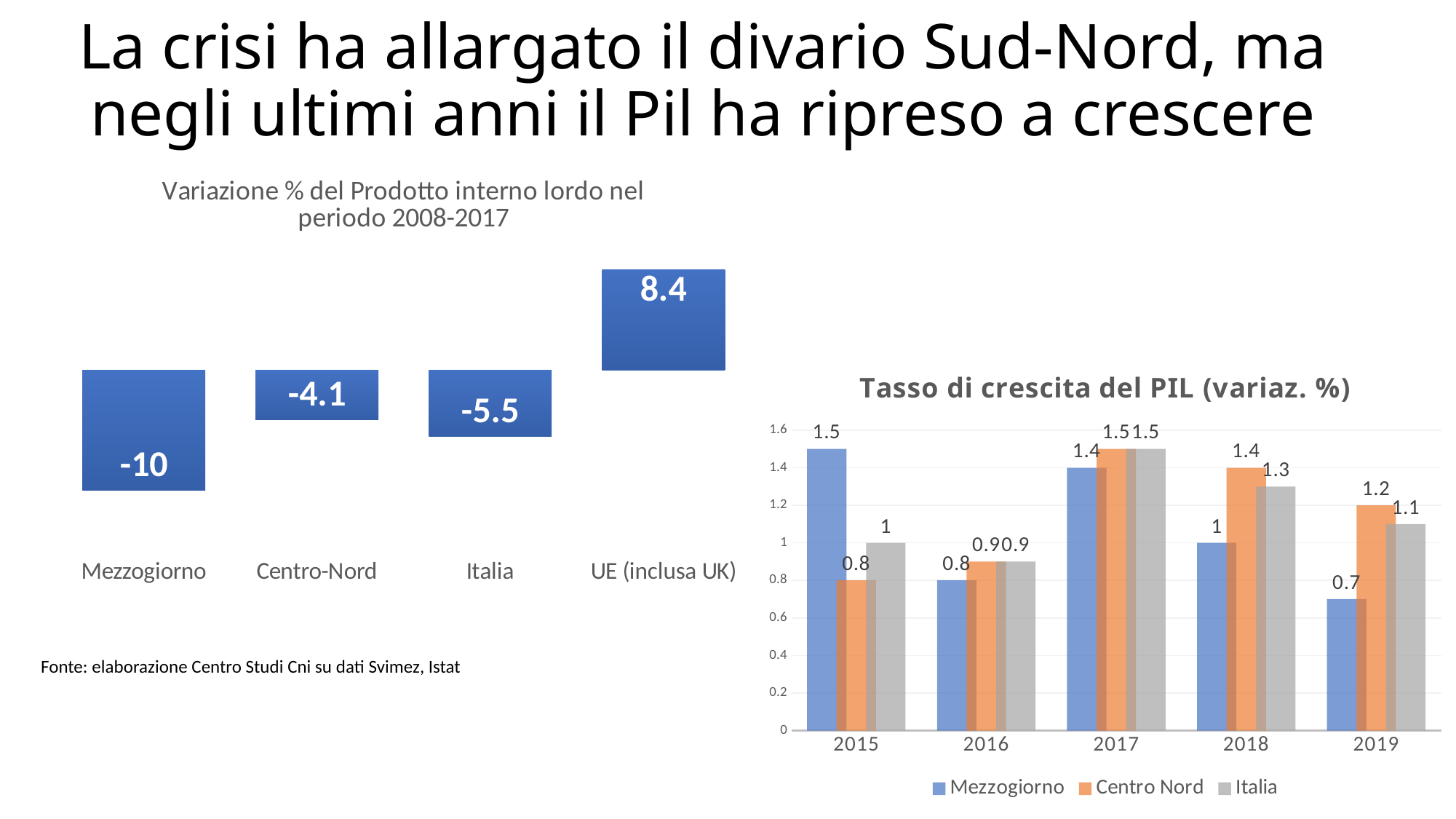
In the chart 'Variazione % del Prodotto interno lordo nel periodo 2008-2017', what is the value for UE (inclusa UK)? 8.4 In the chart 'Variazione % del Prodotto interno lordo nel periodo 2008-2017', what is the value for Mezzogiorno? -10 In the chart 'Tasso di crescita del PIL (variaz. %)', what is the value for Mezzogiorno in 2019? 0.7 In the chart 'Tasso di crescita del PIL (variaz. %)', how many series does the legend list? 3 How many categories are shown in the chart 'Variazione % del Prodotto interno lordo nel periodo 2008-2017'? 4 In the chart 'Tasso di crescita del PIL (variaz. %)', in which year is the Mezzogiorno value highest? 2015 In the chart 'Tasso di crescita del PIL (variaz. %)', do the Mezzogiorno values rise or fall from 2017 to 2019? fall In the chart 'Tasso di crescita del PIL (variaz. %)', which is larger in 2015: Mezzogiorno or Italia? Mezzogiorno In the chart 'Tasso di crescita del PIL (variaz. %)', what is the value for Centro Nord in 2018? 1.4 In the chart 'Variazione % del Prodotto interno lordo nel periodo 2008-2017', which category has the lowest value? Mezzogiorno What kind of chart is 'Tasso di crescita del PIL (variaz. %)'? bar chart In the chart 'Variazione % del Prodotto interno lordo nel periodo 2008-2017', what is the difference between the values for Italia and Centro-Nord? 1.4